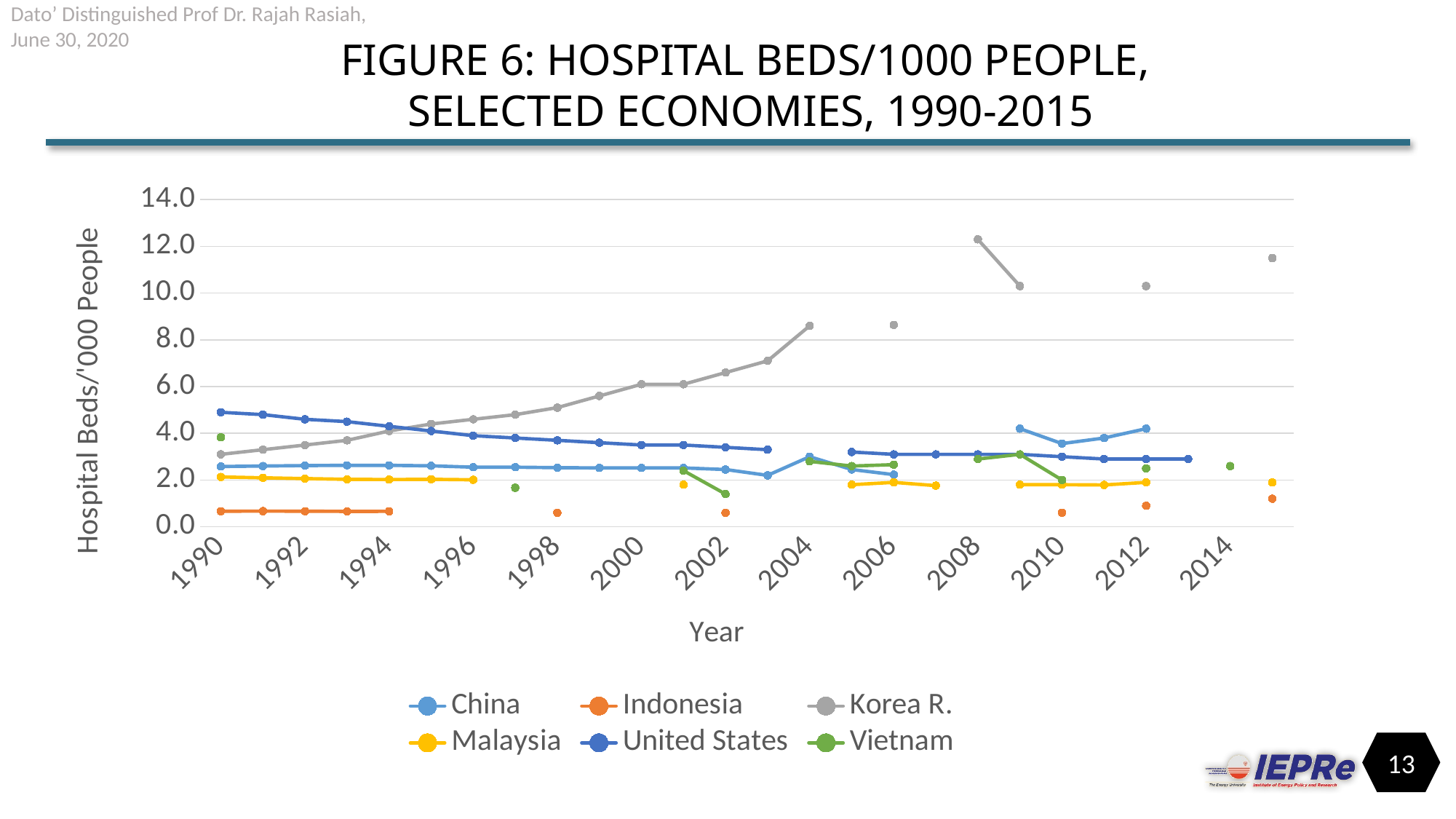
Is the value for Korea R. in 2004 greater or less than 8.0? greater Is the value for Indonesia in 1990 greater or less than 2.0? less Which series has the highest value in 2008? Korea R. Is the value for the United States in 1990 greater or less than 4.0? greater What kind of chart is shown on the slide? Line chart Which series has the lowest value in 1990? Indonesia What is the title of the chart? FIGURE 6: HOSPITAL BEDS/1000 PEOPLE, SELECTED ECONOMIES, 1990-2015 Does the value for Korea R. rise or fall from 1990 to 2004? rise How many series does the legend list? 6 What is the label of the vertical axis? Hospital Beds/'000 People